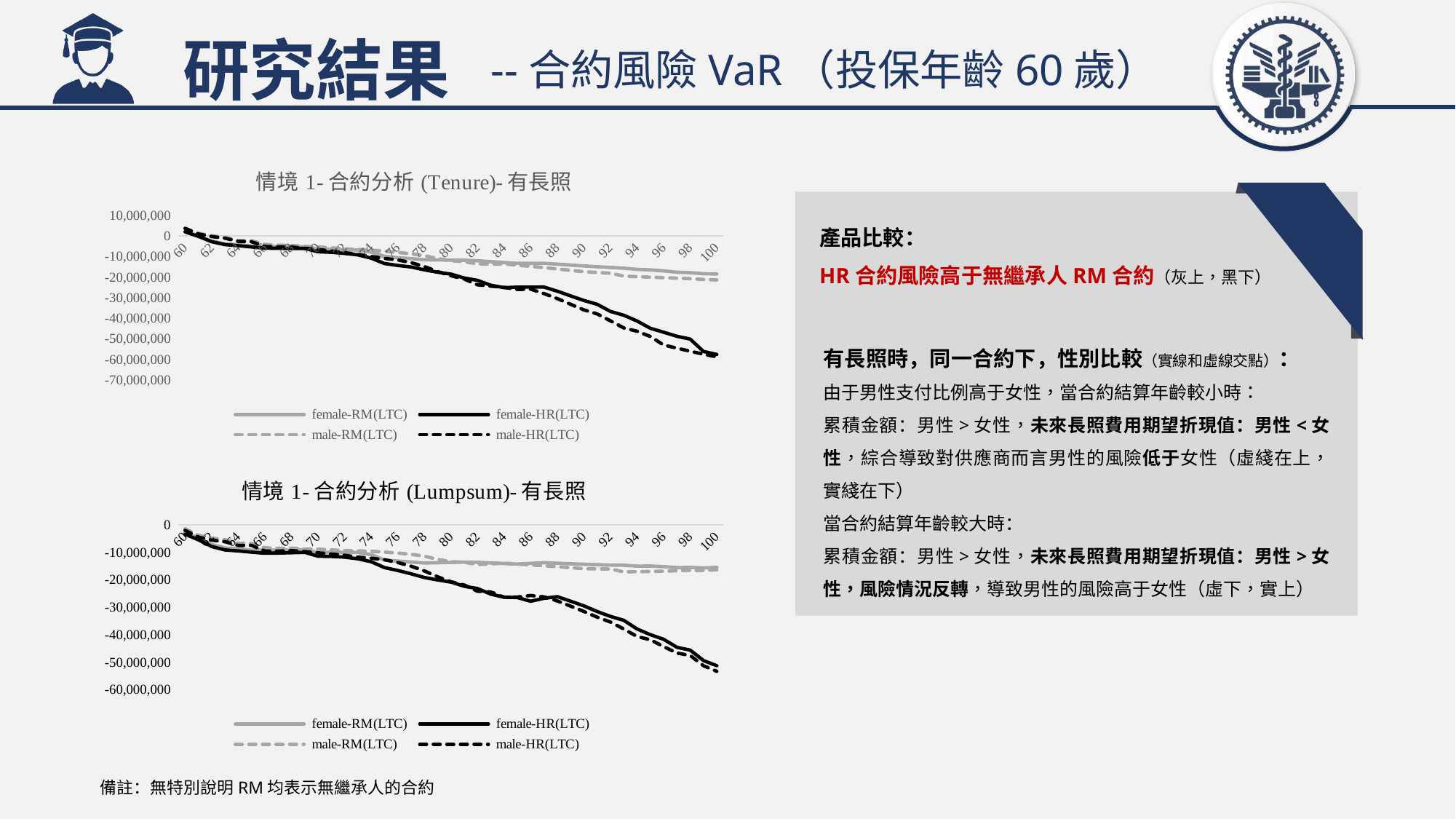
How many age ticks are labelled on the x axis of the bottom chart (Lumpsum)? 21 What kind of chart is the top chart titled 情境 1- 合約分析 (Tenure)- 有長照? line chart What is the title of the bottom chart? 情境 1- 合約分析 (Lumpsum)- 有長照 In the bottom chart (Lumpsum), is the value for male-RM(LTC) at age 100 greater or less than -30,000,000? greater In the top chart (Tenure), at age 100, which is higher: female-RM(LTC) or female-HR(LTC)? female-RM(LTC) How many series does the legend of the bottom chart (Lumpsum) list? 4 How many series does the legend of the top chart (Tenure) list? 4 In the bottom chart (Lumpsum), do the values of male-HR(LTC) rise or fall as age increases along the x axis? fall In the top chart (Tenure), do the values of female-HR(LTC) rise or fall as age increases from 60 to 100? fall In the bottom chart (Lumpsum), is the value for female-HR(LTC) at age 100 greater or less than -40,000,000? less In the top chart (Tenure), is the value for female-RM(LTC) at age 100 greater or less than -30,000,000? greater